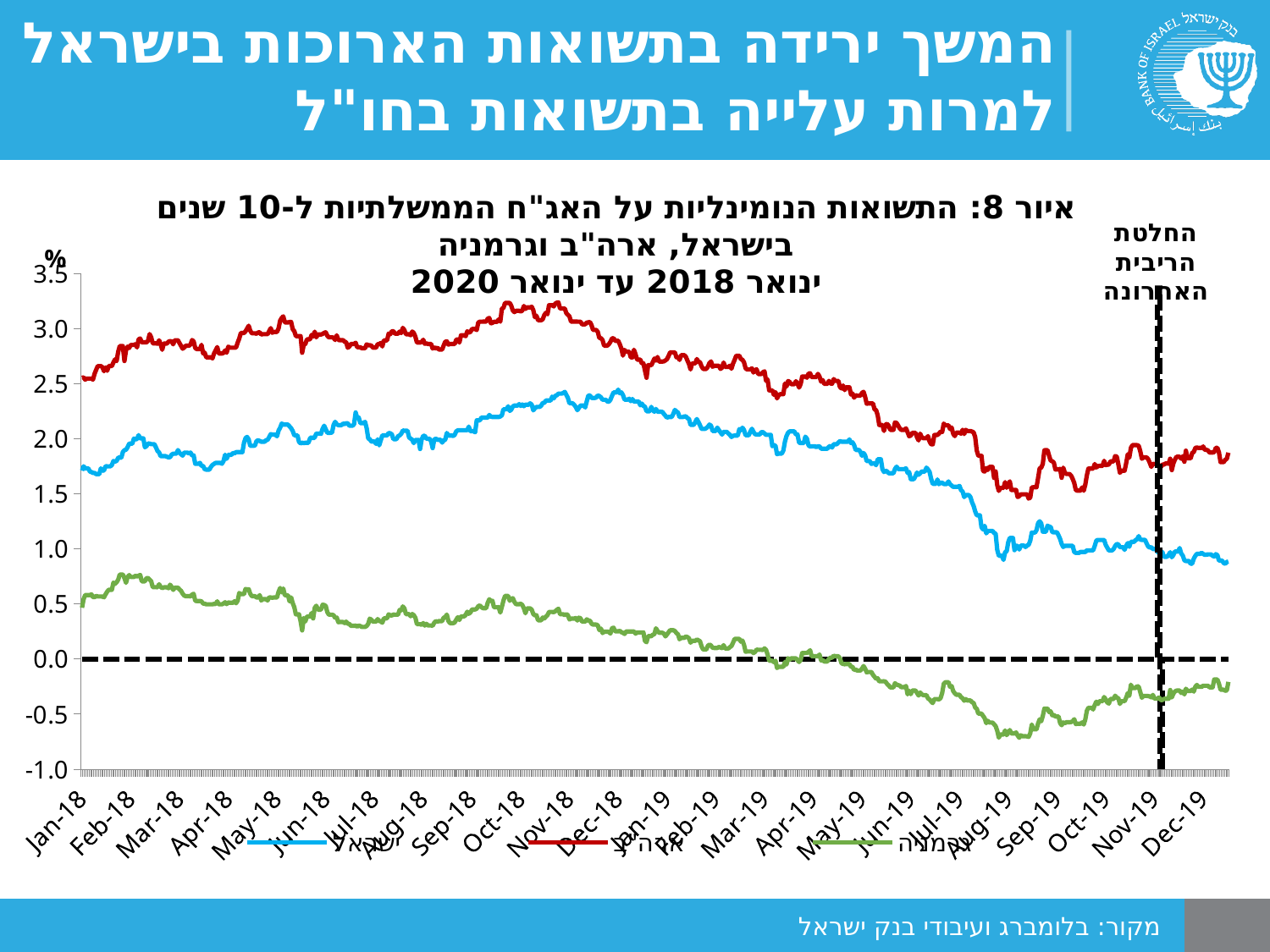
Which series has the highest yield throughout the period shown? ארה"ב (the red line) Which series has the lowest yield throughout the period shown? גרמניה (the green line) What unit is shown at the top of the y axis? % How many series does the chart's legend list? 3 Is the value of the blue (ישראל) line in Nov-18 greater or less than 2.0? greater What kind of chart is shown on the slide? line chart Does the blue (ישראל) line overall rise or fall from Jan-18 to Dec-19? fall Is the value of the red (ארה"ב) line in Oct-18 greater or less than 3.0? greater Is the value of the blue (ישראל) line in Dec-19 greater or less than 1.0? less Which is larger in Jan-19: the value of the red (ארה"ב) line or the blue (ישראל) line? the red (ארה"ב) line What does the vertical dashed line near Nov-19 mark, according to the label on the slide? החלטת הריבית האחרונה